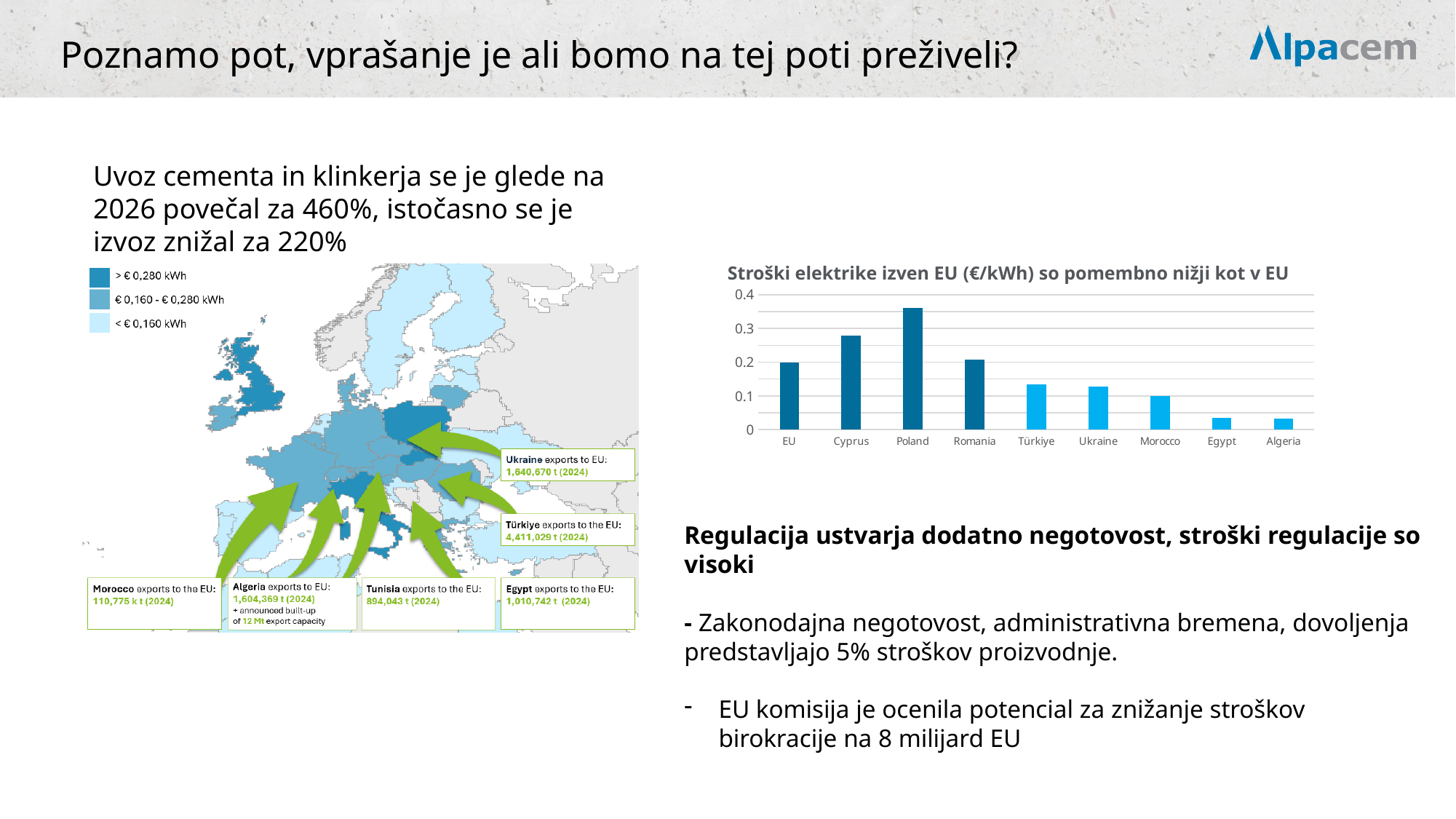
In the bar chart, is the value for Cyprus greater or less than 0.2? greater What is the title of the bar chart on the right? Stroški elektrike izven EU (€/kWh) so pomembno nižji kot v EU In the bar chart, is the value for Ukraine greater or less than 0.2? less In the bar chart, is the value for Egypt greater or less than 0.1? less How many countries/regions are shown on the x axis of the bar chart? 9 In the bar chart, do the values rise or fall from Türkiye to Algeria along the x axis? fall In the bar chart, which country has the highest electricity cost? Poland In the bar chart, which is larger, the value for Cyprus or the value for Romania? Cyprus In the bar chart, which is larger, the value for Türkiye or the value for Morocco? Türkiye On the map on the left, how many tonnes did Ukraine export to the EU in 2024? 1,640,670 t What type of chart is shown on the right side of the slide? bar chart